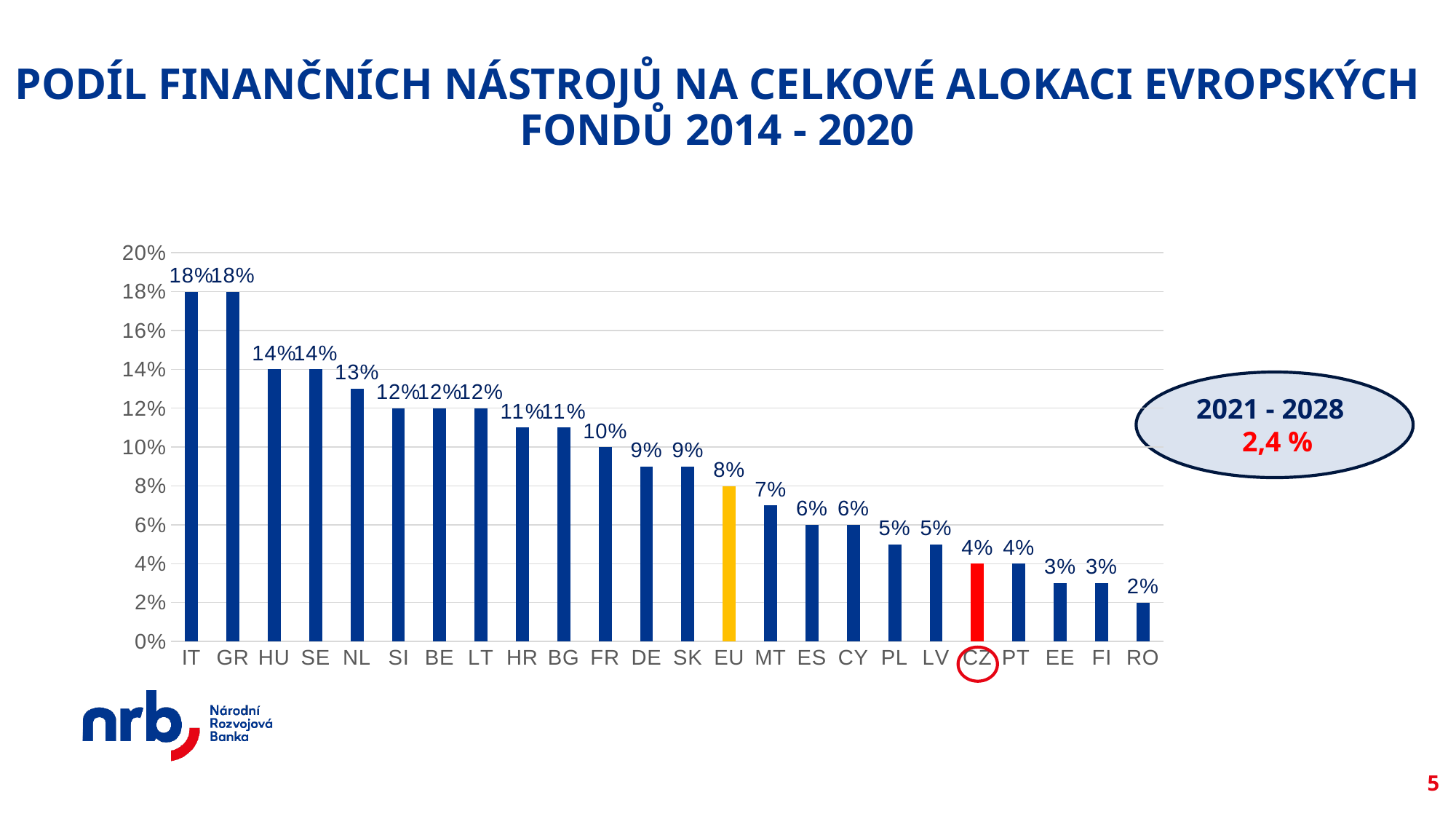
What is the difference between the values for EU and CZ? 4% Which is larger, the value for HU or the value for FR? HU What is the value for EU? 8% What is the value for MT? 7% What is the difference between the values for IT and RO? 16% What colour is the bar for CZ? red How many categories are shown on the x axis? 24 What is the value for CZ? 4% Which category has the lowest value? RO Is the value for SK greater or less than 10%? less What kind of chart is shown on the slide? bar chart What is the value for NL? 13%